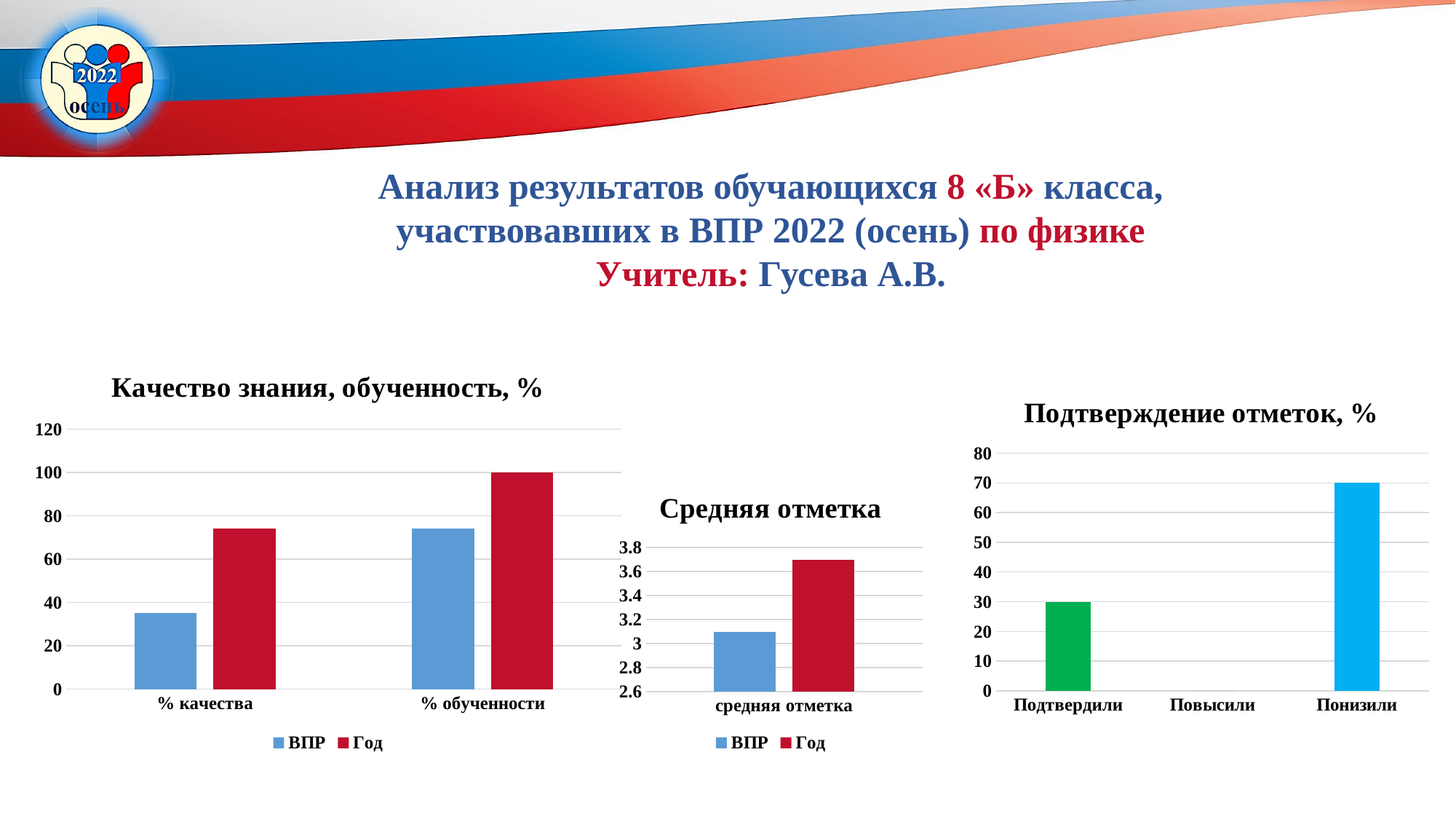
In the 'Подтверждение отметок, %' chart, which category has the highest value? Понизили In the 'Качество знания, обученность, %' chart, how many series does the legend list? 2 In the 'Средняя отметка' chart, is the value of 'ВПР' greater or less than 3.2? less In the 'Качество знания, обученность, %' chart, is the value of 'ВПР' for '% качества' greater or less than 40? less In the 'Качество знания, обученность, %' chart, how many categories are shown on the x axis? 2 In the 'Подтверждение отметок, %' chart, what is the value for 'Понизили'? 70 In the 'Подтверждение отметок, %' chart, how many categories are shown on the x axis? 3 What kind of chart is the 'Качество знания, обученность, %' chart? bar chart In the 'Подтверждение отметок, %' chart, what is the value for 'Подтвердили'? 30 In the 'Качество знания, обученность, %' chart, what is the value of 'Год' for '% обученности'? 100 In the 'Средняя отметка' chart, which series has the larger value: 'ВПР' or 'Год'? Год In the 'Качество знания, обученность, %' chart, which is larger for '% качества': 'ВПР' or 'Год'? Год